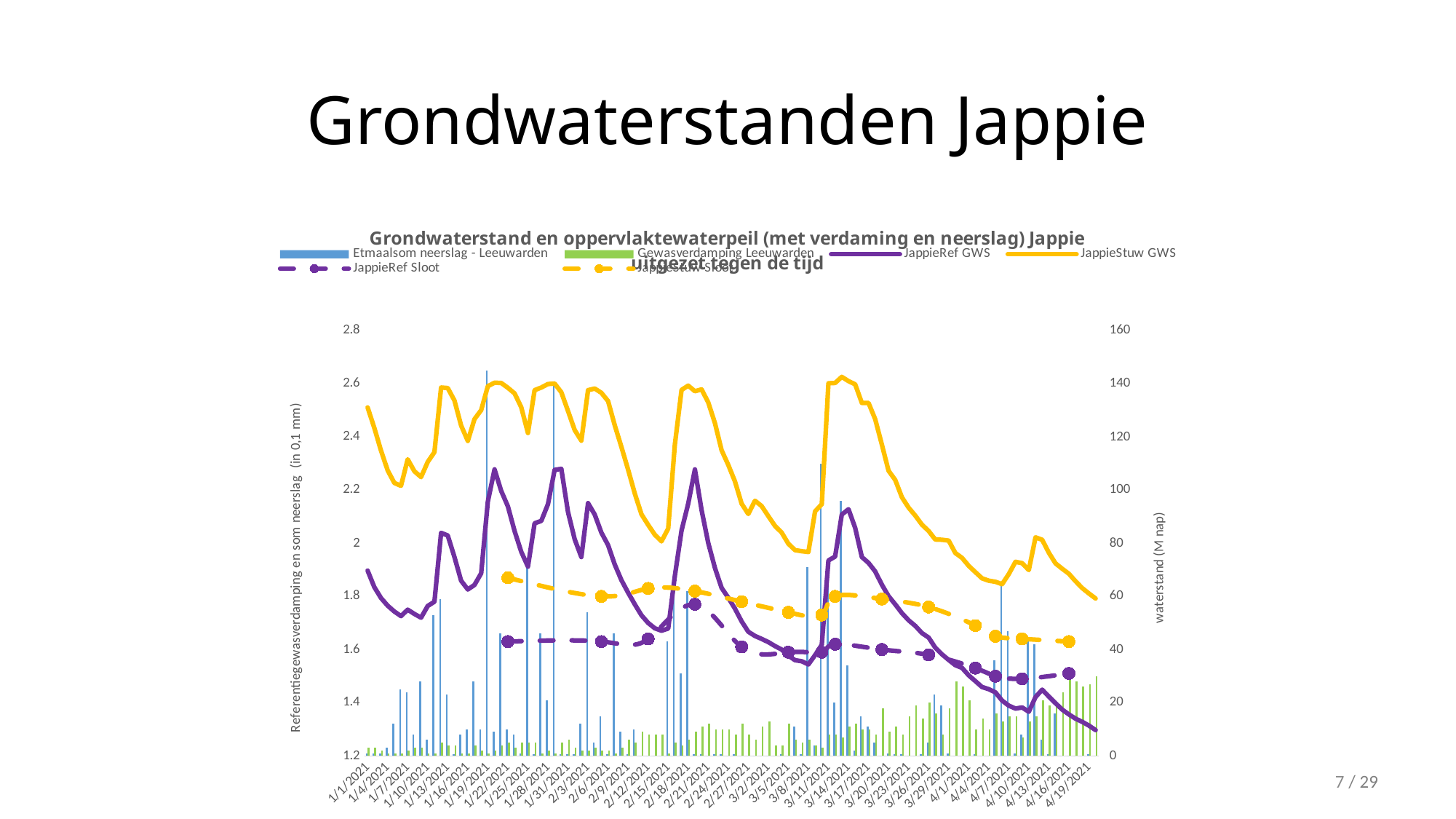
Is the value of JappieStuw GWS at 4/19/2021 greater or less than 2? less Does the JappieStuw GWS line generally rise or fall from 1/1/2021 to 4/19/2021? Fall Is the value of JappieRef GWS at 4/19/2021 greater or less than 1.4? less Which is larger at 2/6/2021: JappieStuw Sloot or JappieRef Sloot? JappieStuw Sloot Which is larger at 3/14/2021: JappieStuw GWS or JappieRef GWS? JappieStuw GWS How many series does the chart legend list? 6 Is the value of JappieStuw GWS at 1/22/2021 greater or less than 2.4? greater Does the JappieRef Sloot line generally rise or fall across the period shown? Fall What is the highest tick value shown on the right-hand vertical axis? 160 What kind of chart is shown on the slide? Combined bar and line chart What is the label of the right-hand vertical axis? waterstand (M nap)